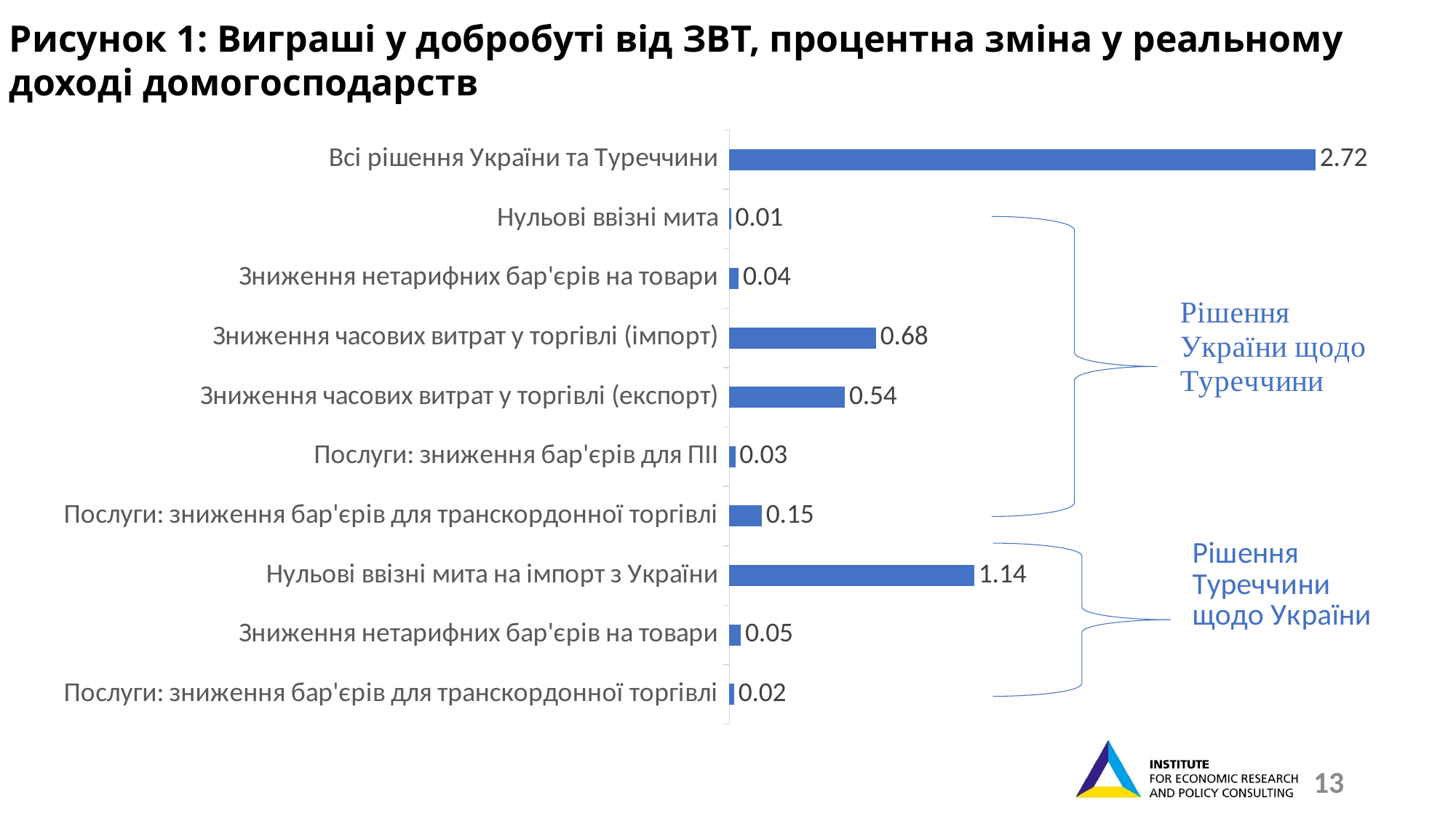
What is the value for "Послуги: зниження бар'єрів для транскордонної торгівлі" in the group "Рішення України щодо Туреччини"? 0.15 Which category has the highest value? Всі рішення України та Туреччини What is the value for "Нульові ввізні мита на імпорт з України"? 1.14 What is the value for "Послуги: зниження бар'єрів для ПІІ"? 0.03 What is the difference between "Зниження часових витрат у торгівлі (імпорт)" and "Зниження часових витрат у торгівлі (експорт)"? 0.14 What is the value for "Зниження часових витрат у торгівлі (імпорт)"? 0.68 What kind of chart is shown on the slide? Bar chart Which is larger: "Нульові ввізні мита на імпорт з України" or "Зниження часових витрат у торгівлі (імпорт)"? Нульові ввізні мита на імпорт з України What is the value for "Всі рішення України та Туреччини"? 2.72 How many categories (bars) does the chart show? 10 What is the value for "Зниження нетарифних бар'єрів на товари" in the group "Рішення Туреччини щодо України"? 0.05 Which category has the lowest value? Нульові ввізні мита